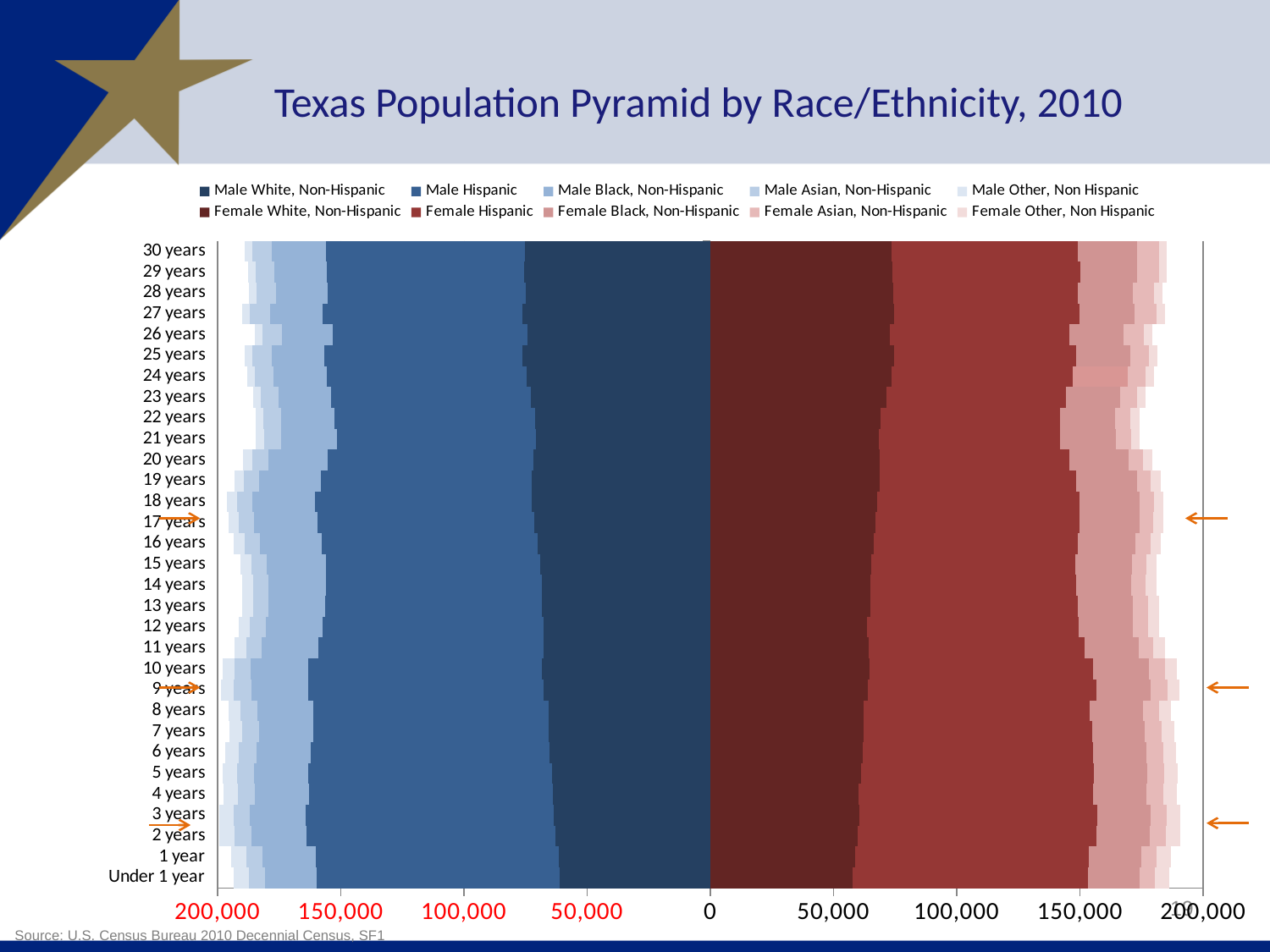
Is the Female White, Non-Hispanic value for 30 years greater or less than 50,000? greater Is the total male population for 30 years greater or less than 150,000? greater How many age categories are shown on the vertical axis? 31 What is the maximum value shown on the horizontal axis? 200,000 What kind of chart is shown on the slide? Bar chart (stacked horizontal population pyramid) Is the total female population for 9 years greater or less than 150,000? greater What is the title of the chart? Texas Population Pyramid by Race/Ethnicity, 2010 Which age category is at the bottom of the vertical axis? Under 1 year How many series does the legend list? 10